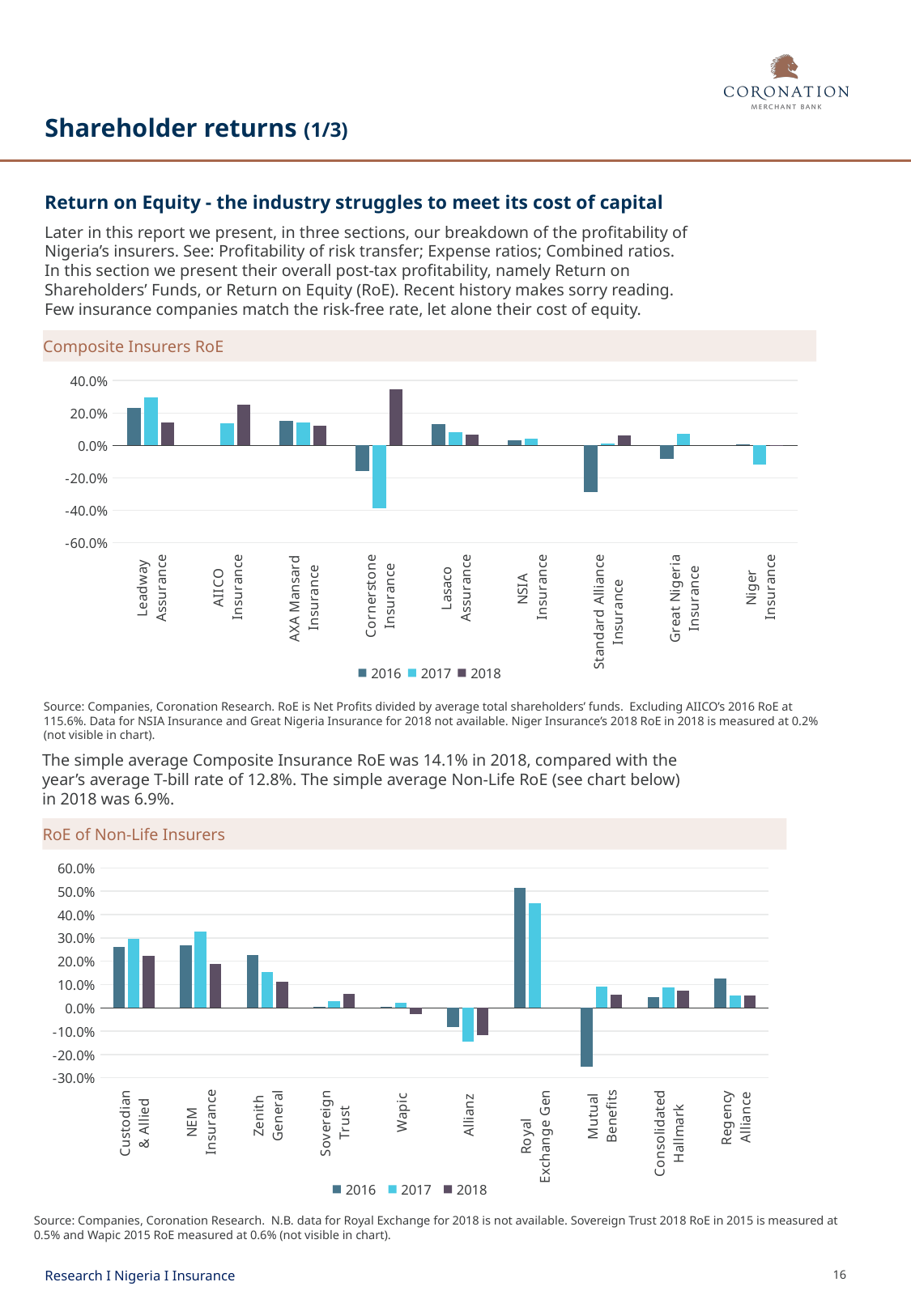
In the 'RoE of Non-Life Insurers' chart, is the 2016 value for Royal Exchange Gen greater or less than 40.0%? greater What type of chart is the 'Composite Insurers RoE' chart? bar chart How many insurers are shown on the x axis of the 'RoE of Non-Life Insurers' chart? 10 In the 'RoE of Non-Life Insurers' chart, which insurer has the lowest 2016 value? Mutual Benefits In the 'Composite Insurers RoE' chart, is the 2017 value for Cornerstone Insurance greater or less than -20.0%? less How many insurers are shown on the x axis of the 'Composite Insurers RoE' chart? 9 In the 'Composite Insurers RoE' chart, which is larger: the 2017 value for Leadway Assurance or the 2017 value for AXA Mansard Insurance? Leadway Assurance What are the legend entries of the 'Composite Insurers RoE' chart? 2016, 2017, 2018 In the 'Composite Insurers RoE' chart, which insurer has the highest 2018 value? Cornerstone Insurance In the 'RoE of Non-Life Insurers' chart, which insurer has the highest 2016 value? Royal Exchange Gen In the 'Composite Insurers RoE' chart, which insurer has the lowest 2017 value? Cornerstone Insurance How many series does the legend of the 'RoE of Non-Life Insurers' chart list? 3